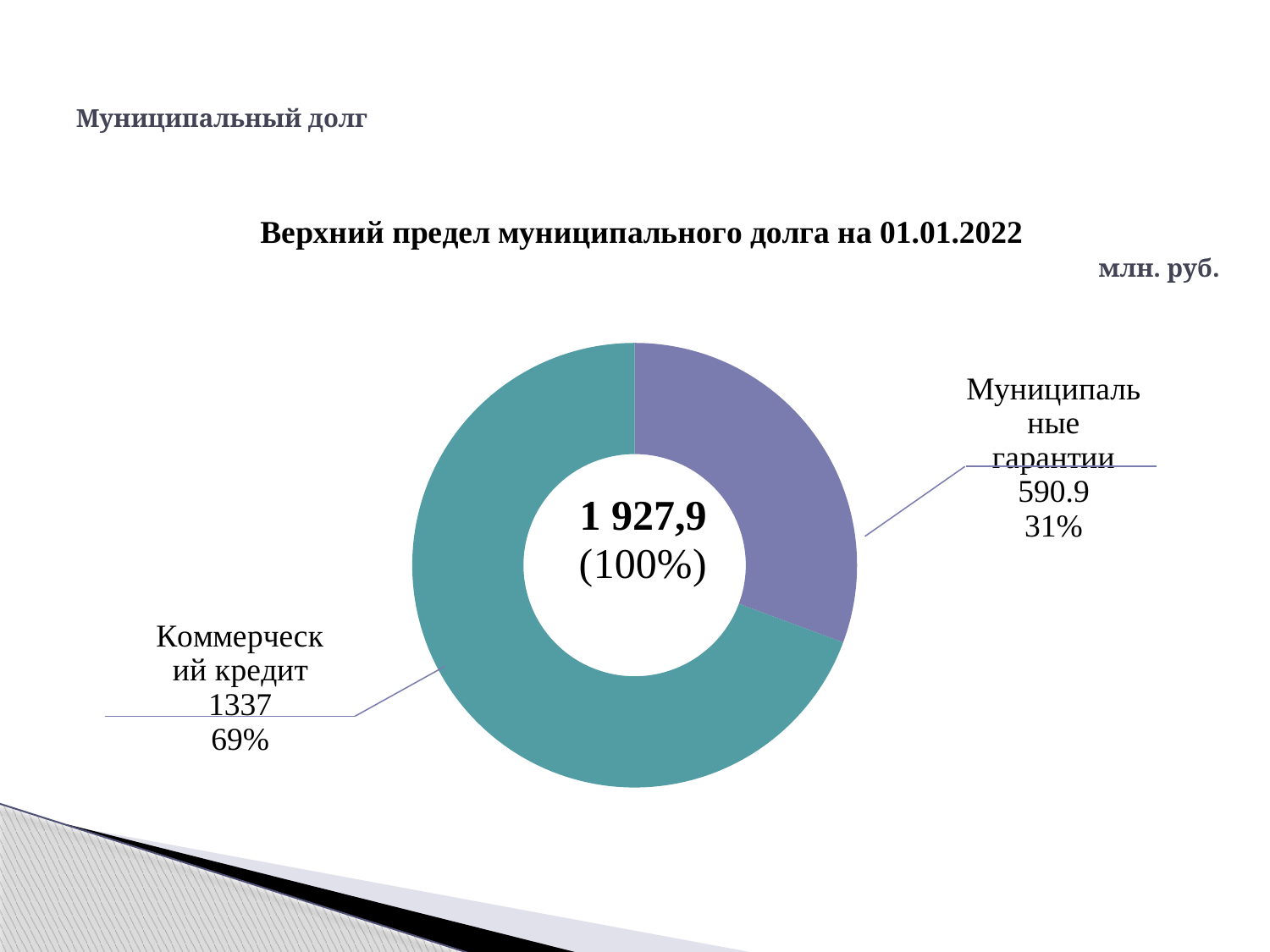
What is the value for Коммерческий кредит? 1337 What is the value for Муниципальные гарантии? 590.9 What is the title of the chart? Верхний предел муниципального долга на 01.01.2022 Which is larger, Коммерческий кредит or Муниципальные гарантии? Коммерческий кредит What total value is shown in the centre of the chart? 1 927,9 Which category has the largest slice? Коммерческий кредит How many categories does the chart show? 2 What kind of chart is shown on the slide? Donut (pie) chart Which category has the smallest slice? Муниципальные гарантии What is the difference between the values for Коммерческий кредит and Муниципальные гарантии? 746.1 What share of the chart does Муниципальные гарантии represent? 31% What share of the chart does Коммерческий кредит represent? 69%